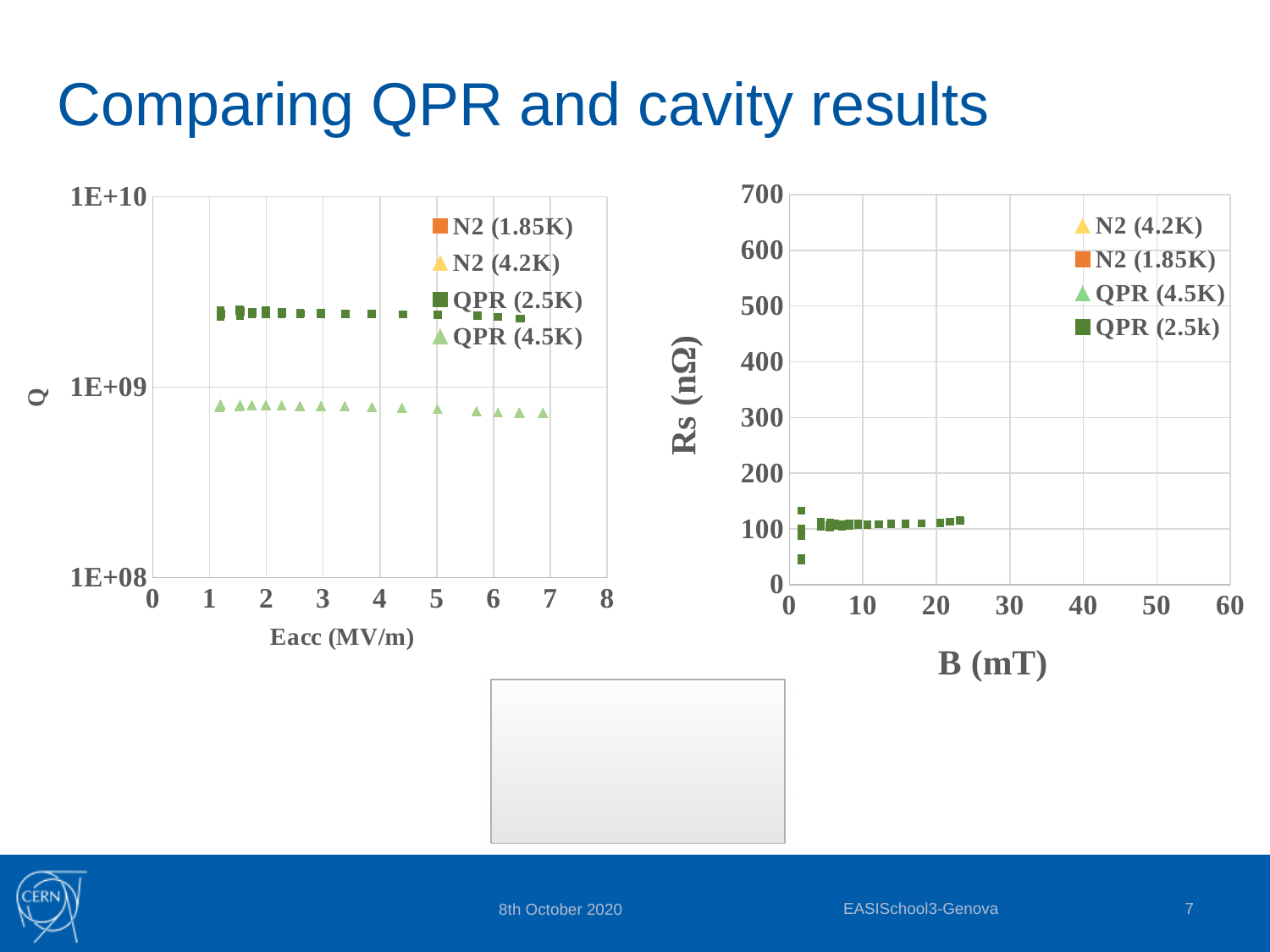
In the right chart (Rs vs B), is the Rs value for QPR (2.5k) at B = 10 mT greater or less than 200 nΩ? less In the left chart (Q vs Eacc), which series has the higher Q values, QPR (2.5K) or QPR (4.5K)? QPR (2.5K) How many series does the legend of the left chart (Q vs Eacc) list? 4 In the left chart (Q vs Eacc), do the QPR (4.5K) values rise, fall or stay roughly flat as Eacc increases? roughly flat What is the label of the x axis of the right chart? B (mT) In the left chart (Q vs Eacc), is the Q value for QPR (2.5K) at Eacc = 3 MV/m greater or less than 1E+09? greater What kind of chart is the right chart (Rs vs B)? scatter chart In the right chart (Rs vs B), is the Rs value for QPR (2.5k) at B = 20 mT greater or less than 300 nΩ? less What kind of chart is the left chart (Q vs Eacc)? scatter chart What is the label of the y axis of the right chart? Rs (nΩ) How many series does the legend of the right chart (Rs vs B) list? 4